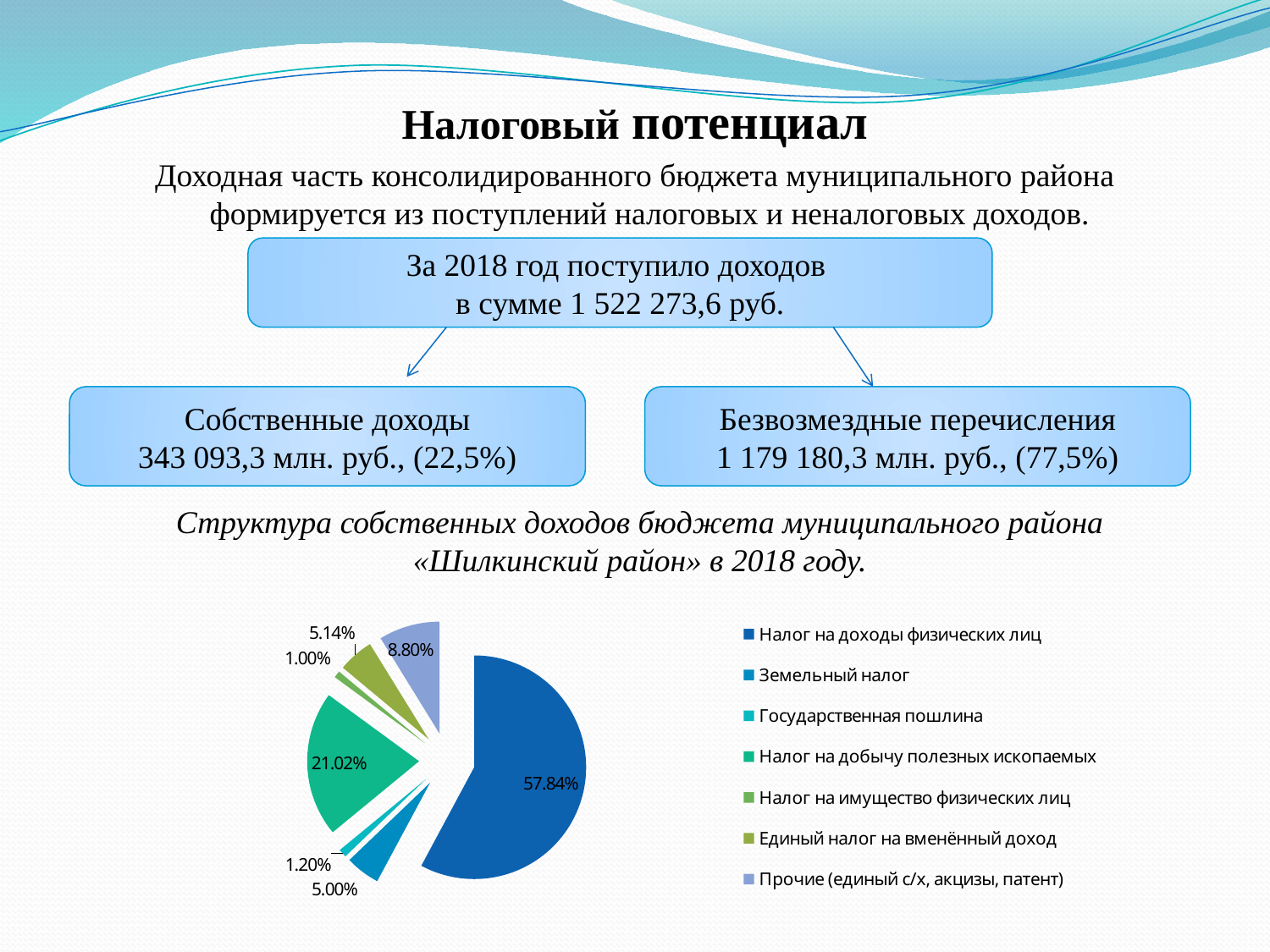
What is the value shown for "Земельный налог"? 5.00% What is the value shown for "Прочие (единый с/х, акцизы, патент)"? 8.80% How many entries does the legend of the pie chart list? 7 What share of the pie does "Налог на добычу полезных ископаемых" have? 21.02% What is the difference between the shares of "Налог на доходы физических лиц" and "Налог на добычу полезных ископаемых"? 36.82% What share of the pie does "Налог на доходы физических лиц" have? 57.84% Which is larger: the share of "Единый налог на вменённый доход" or the share of "Земельный налог"? Единый налог на вменённый доход What kind of chart is shown on the slide? pie chart Which category has the largest share of the pie? Налог на доходы физических лиц What colour is the slice for "Налог на доходы физических лиц"? dark blue How many slices does the pie chart have? 7 Which category has the smallest share of the pie? Налог на имущество физических лиц